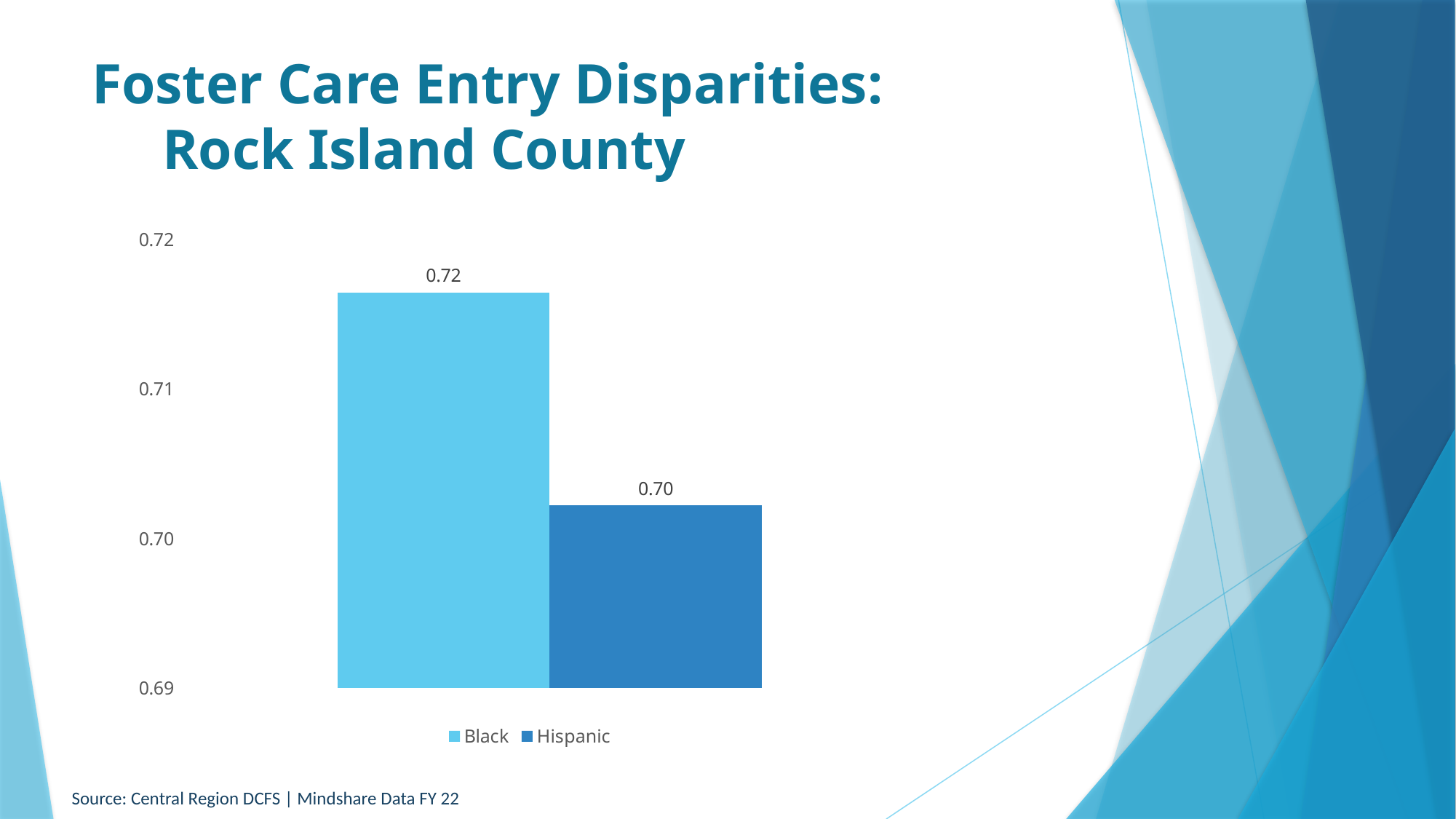
What kind of chart is shown on the slide? bar chart How many series does the legend list? 2 Is the value for Black greater or less than 0.71? greater Which is larger, the value for Black or the value for Hispanic? Black What is the value for Black? 0.72 What is the value for Hispanic? 0.70 How many bars are plotted on the chart? 2 Which group has the highest value? Black Which group has the lowest value? Hispanic Is the value for Hispanic greater or less than 0.71? less What is the title of the slide? Foster Care Entry Disparities: Rock Island County What is the difference between the values for Black and Hispanic? 0.02